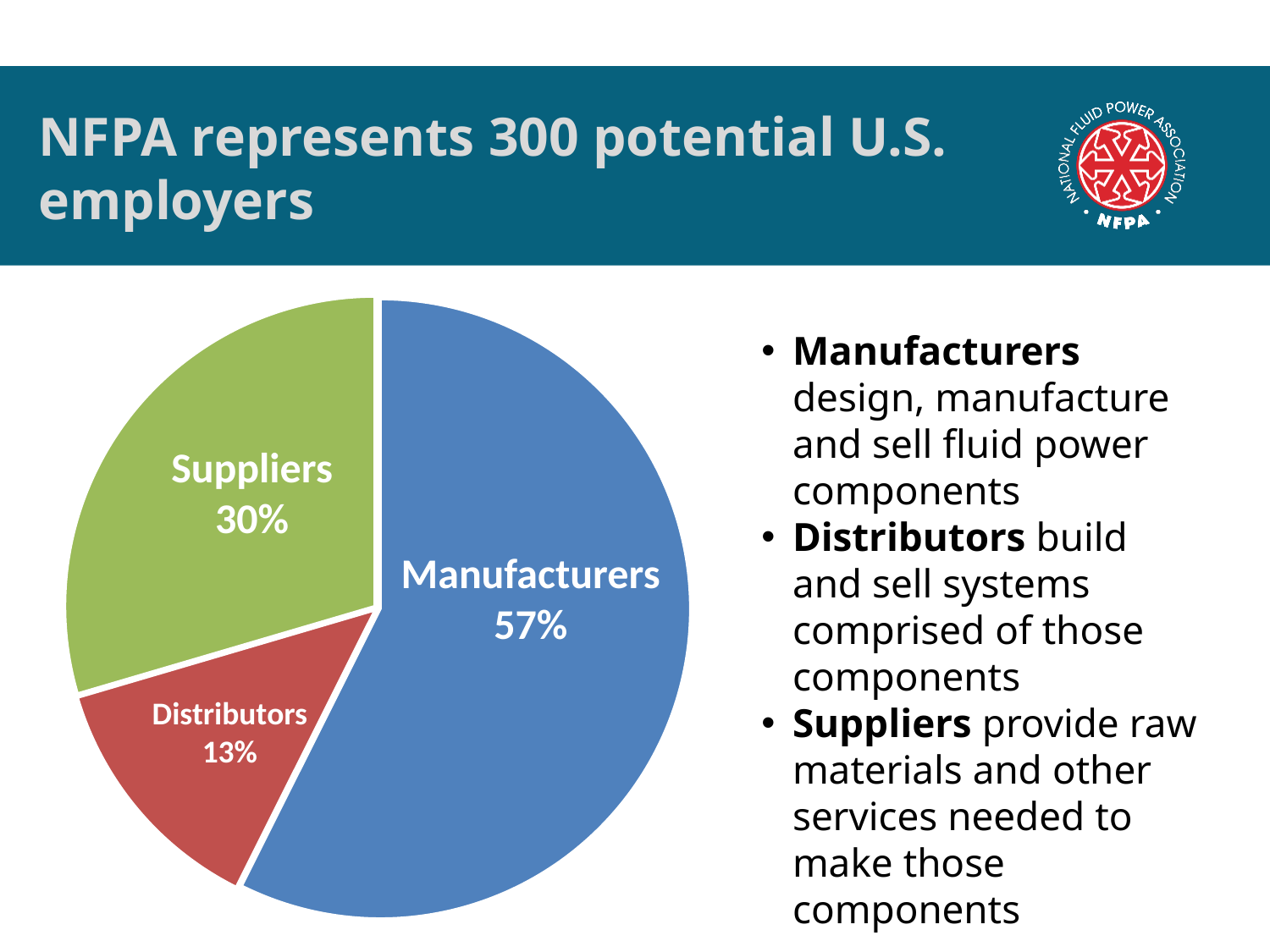
What share of the pie do Manufacturers represent? 57% What kind of chart is shown on the slide? Pie chart Which is larger, the Suppliers slice or the Distributors slice? Suppliers What colour is the Distributors slice? Red Which category has the smallest slice of the pie? Distributors How many slices does the pie chart have? 3 What is the difference in percentage points between Manufacturers and Suppliers? 27 What share of the pie do Distributors represent? 13% What share of the pie do Suppliers represent? 30% What colour is the Manufacturers slice? Blue Which category has the largest slice of the pie? Manufacturers What is the difference in percentage points between Suppliers and Distributors? 17